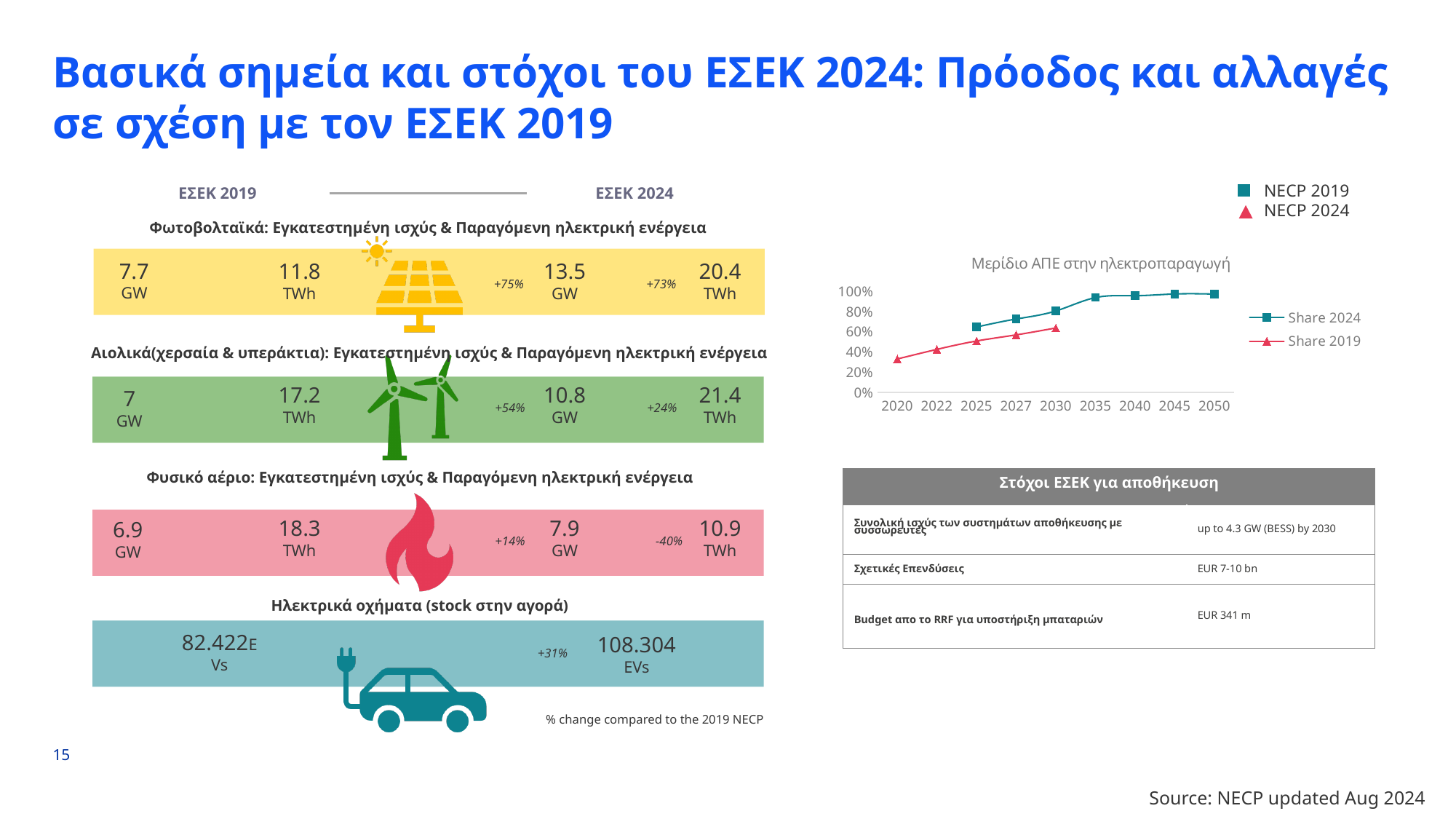
In the 'Μερίδιο ΑΠΕ στην ηλεκτροπαραγωγή' chart, which year has the lowest Share 2019 value? 2020 In the 'Μερίδιο ΑΠΕ στην ηλεκτροπαραγωγή' chart, is the Share 2019 value for 2020 greater or less than 40%? less In the 'Μερίδιο ΑΠΕ στην ηλεκτροπαραγωγή' chart, which year has the lowest Share 2024 value? 2025 In the 'Μερίδιο ΑΠΕ στην ηλεκτροπαραγωγή' chart, is the Share 2024 value for 2035 greater or less than 80%? greater In the 'Μερίδιο ΑΠΕ στην ηλεκτροπαραγωγή' chart, is the Share 2024 value for 2030 greater or less than 60%? greater In the 'Μερίδιο ΑΠΕ στην ηλεκτροπαραγωγή' chart, which marker shape is used for the NECP 2024 series? triangle How many series does the legend of the 'Μερίδιο ΑΠΕ στην ηλεκτροπαραγωγή' chart list? 2 What kind of chart is the chart titled 'Μερίδιο ΑΠΕ στην ηλεκτροπαραγωγή'? line chart In the 'Μερίδιο ΑΠΕ στην ηλεκτροπαραγωγή' chart, how many year labels are shown on the x axis? 9 In the 'Μερίδιο ΑΠΕ στην ηλεκτροπαραγωγή' chart, do the Share 2019 values rise or fall from 2020 to 2030? rise In the 'Μερίδιο ΑΠΕ στην ηλεκτροπαραγωγή' chart, do the Share 2024 values rise or fall from 2025 to 2050? rise In the 'Μερίδιο ΑΠΕ στην ηλεκτροπαραγωγή' chart, which series has the larger value in 2030, Share 2024 or Share 2019? Share 2024